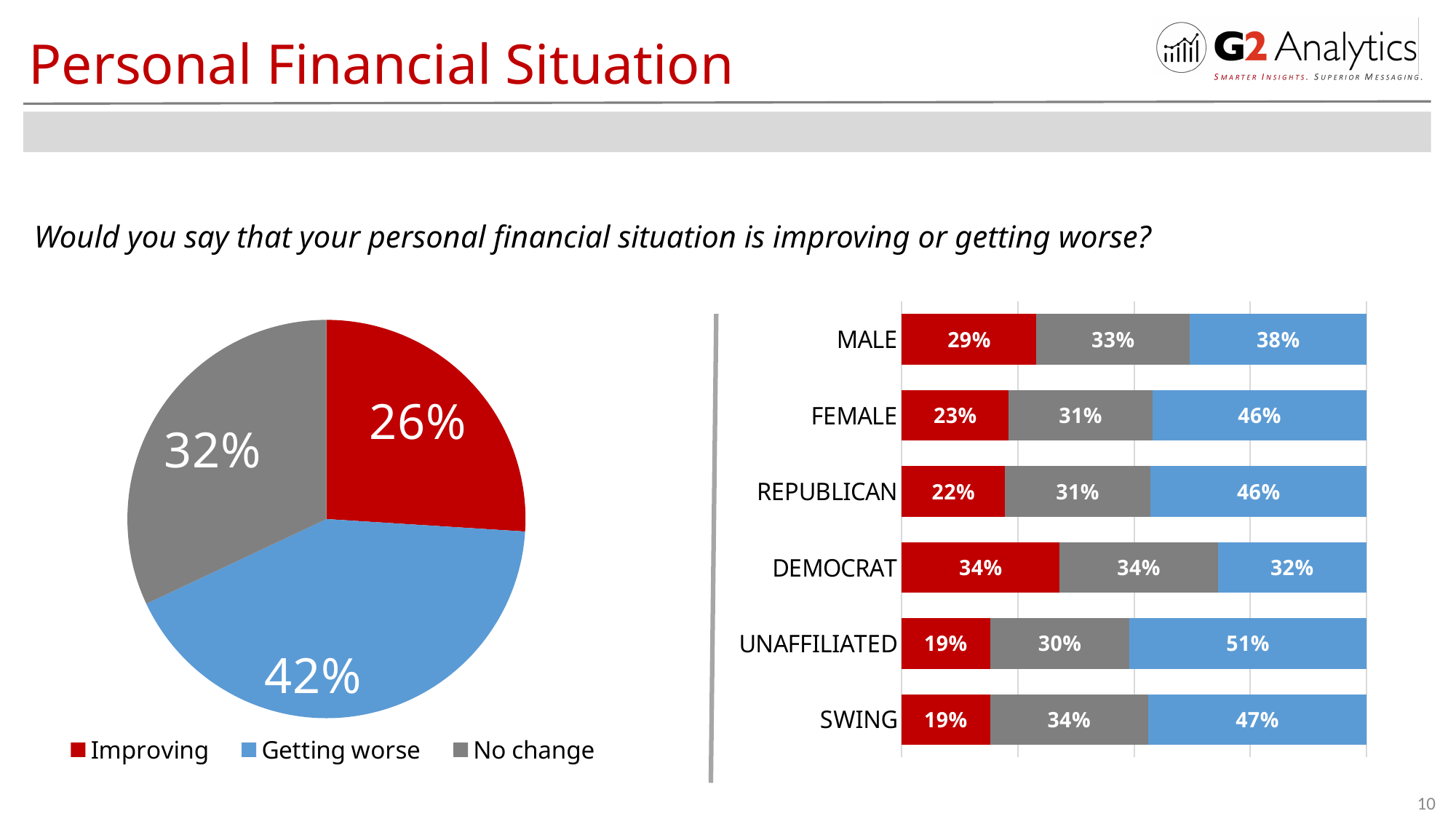
In the bar chart on the right, what is the value of the blue segment for UNAFFILIATED? 51% In the bar chart on the right, which group has the largest red segment? DEMOCRAT What kind of chart is the chart on the left of the slide? pie chart In the bar chart on the right, which group has the smallest blue segment? DEMOCRAT In the bar chart on the right, what is the difference between the blue segment for SWING and the blue segment for MALE? 9% What kind of chart is the chart on the right of the slide? bar chart In the bar chart on the right, is the red segment larger for MALE or for FEMALE? MALE In the pie chart on the left, what share is labelled for Getting worse? 42% In the pie chart on the left, what is the difference between the Getting worse share and the No change share? 10% In the bar chart on the right, how many groups are shown? 6 In the pie chart on the left, how many categories does the legend list? 3 In the pie chart on the left, which category has the smallest slice? Improving